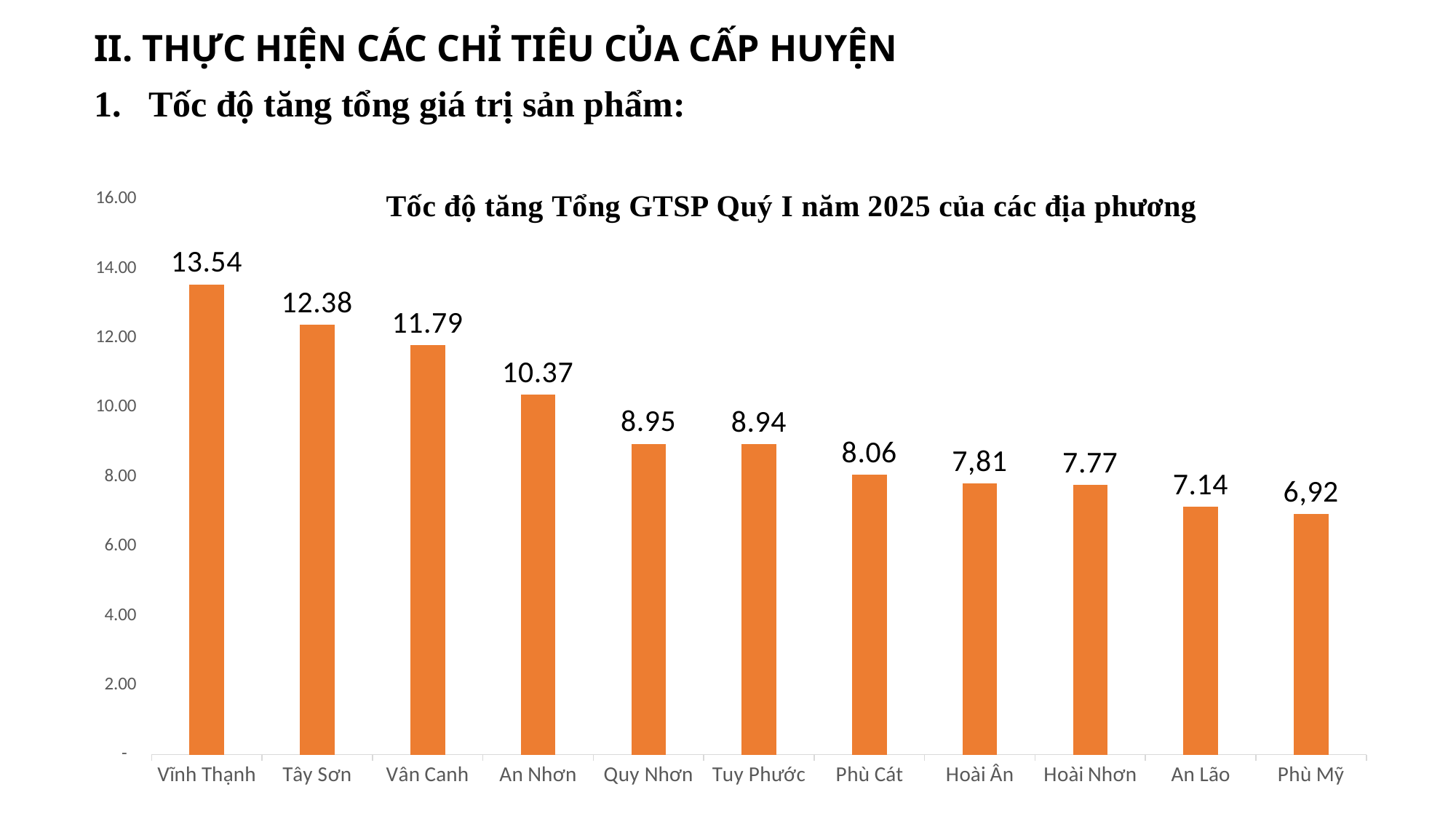
How many localities are shown on the chart? 11 Which locality has the lowest value? Phù Mỹ Which is larger, the value for Vân Canh or the value for Hoài Nhơn? Vân Canh What is the title of the chart? Tốc độ tăng Tổng GTSP Quý I năm 2025 của các địa phương What is the value for Phù Mỹ? 6,92 What is the value for Hoài Ân? 7,81 What is the value for Vĩnh Thạnh? 13.54 What is the value for An Nhơn? 10.37 What kind of chart is shown? Bar chart What is the difference between the values for An Nhơn and Phù Cát? 2.31 What is the difference between the values for Vĩnh Thạnh and Tây Sơn? 1.16 Which locality has the highest value? Vĩnh Thạnh